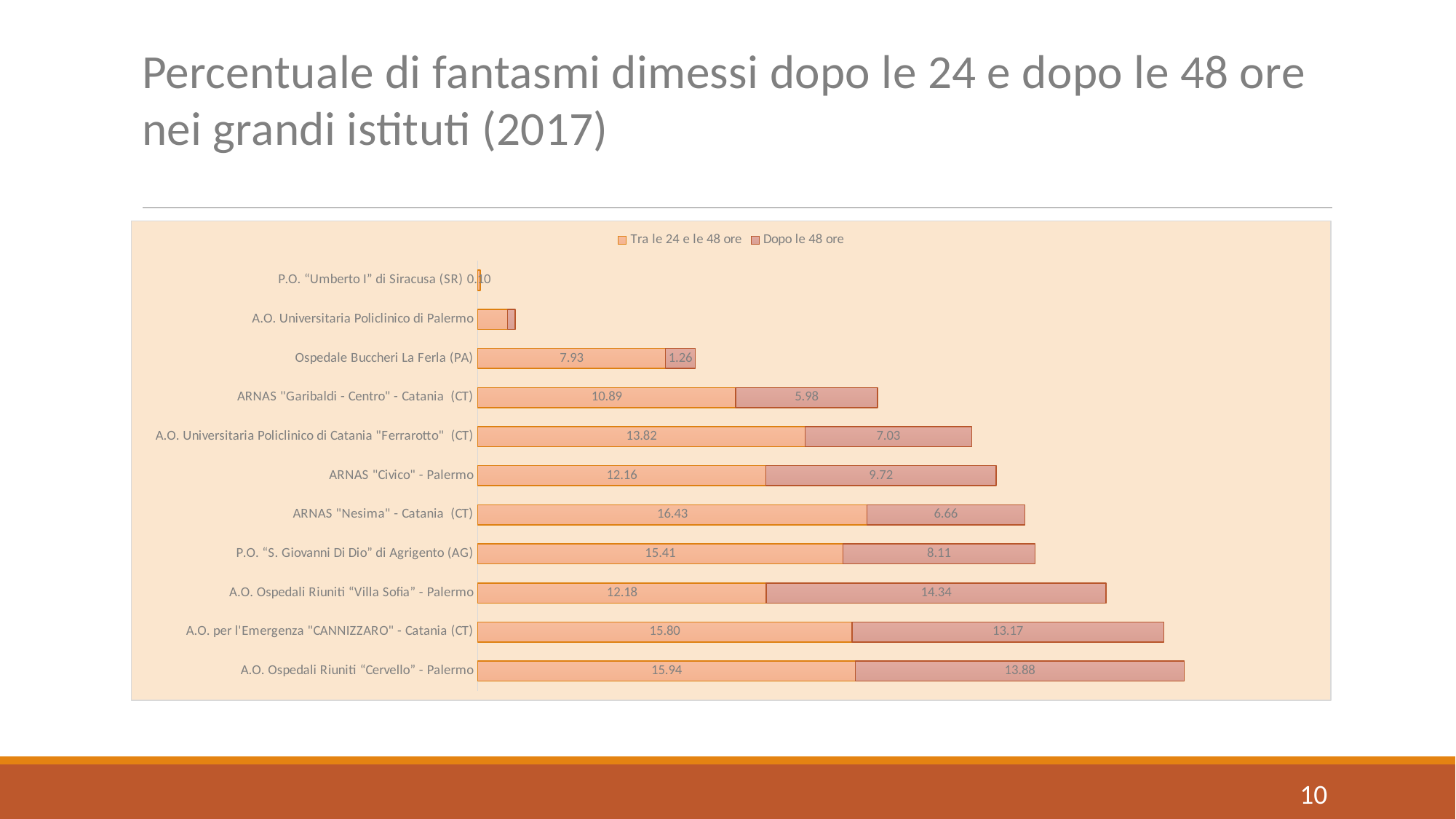
What is the difference between the "Tra le 24 e le 48 ore" and "Dopo le 48 ore" values for ARNAS "Nesima" - Catania (CT)? 9.77 What type of chart is shown on the slide? Stacked bar chart For A.O. Ospedali Riuniti "Villa Sofia" - Palermo, which is larger: "Tra le 24 e le 48 ore" or "Dopo le 48 ore"? Dopo le 48 ore Which institute has the lowest value for "Tra le 24 e le 48 ore"? P.O. "Umberto I" di Siracusa (SR) What are the two legend entries of the chart? Tra le 24 e le 48 ore; Dopo le 48 ore What is the value of "Dopo le 48 ore" for Ospedale Buccheri La Ferla (PA)? 1.26 What is the total of the stacked bar for A.O. Ospedali Riuniti "Cervello" - Palermo? 29.82 Which institute has the highest value for "Tra le 24 e le 48 ore"? ARNAS "Nesima" - Catania (CT) How many series does the legend list? 2 How many institutes (categories) are plotted in the chart? 11 What is the value of "Tra le 24 e le 48 ore" for ARNAS "Nesima" - Catania (CT)? 16.43 What is the value of "Dopo le 48 ore" for A.O. Ospedali Riuniti "Villa Sofia" - Palermo? 14.34